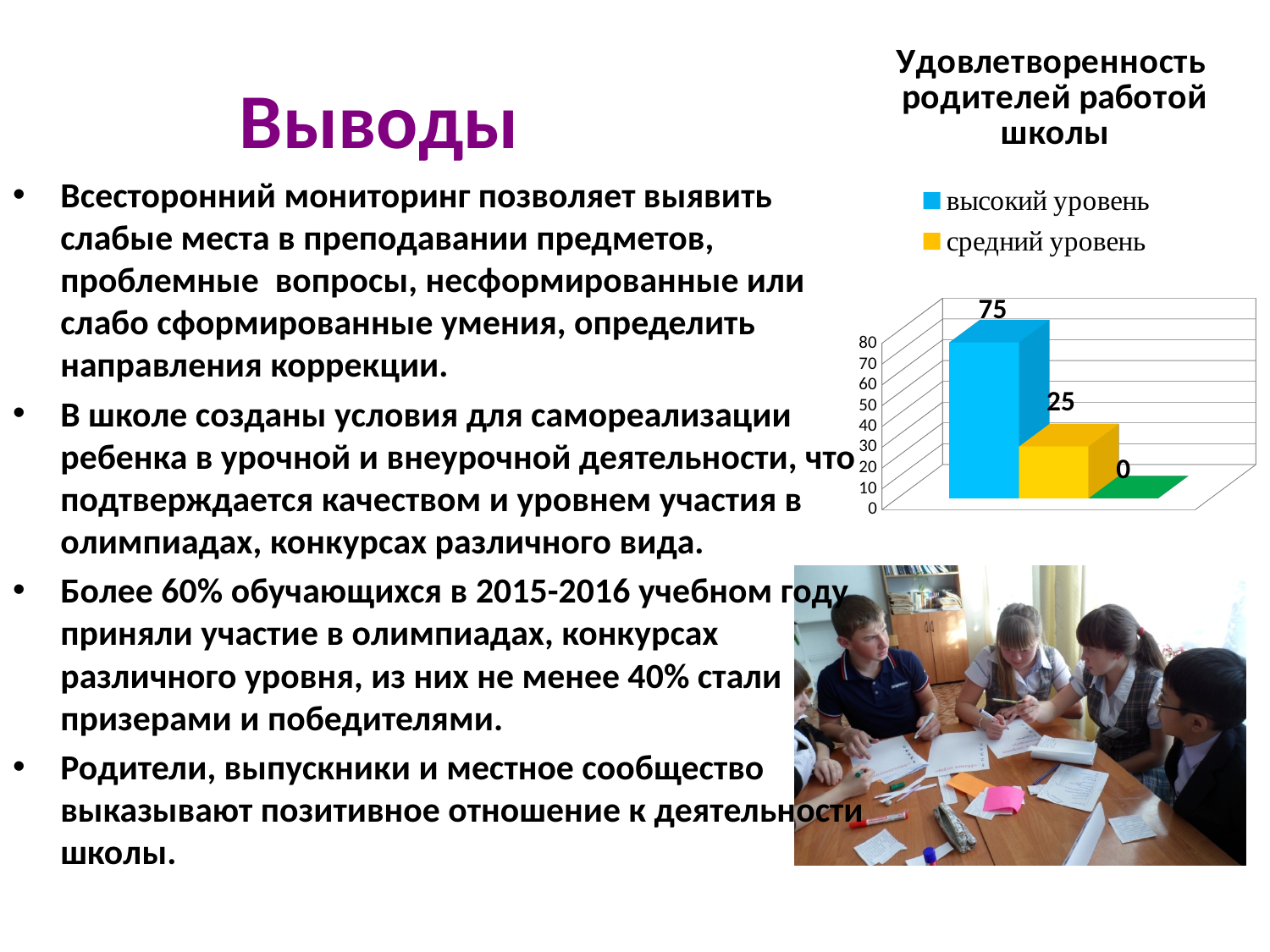
What kind of chart is shown on the slide? bar chart Which legend entry has the highest value in the chart Удовлетворенность родителей работой школы? высокий уровень How many bars are plotted in the chart Удовлетворенность родителей работой школы? 3 What is the title of the chart on the slide? Удовлетворенность родителей работой школы How many series does the legend of the chart list? 2 Is the value for средний уровень greater or less than 40? less Which is larger in the chart: высокий уровень or средний уровень? высокий уровень What is the difference between the values for высокий уровень and средний уровень in the chart? 50 Is the value for высокий уровень greater or less than 50? greater What colour is the bar for высокий уровень in the chart? blue What is the value for средний уровень in the chart Удовлетворенность родителей работой школы? 25 What is the value for высокий уровень in the chart Удовлетворенность родителей работой школы? 75